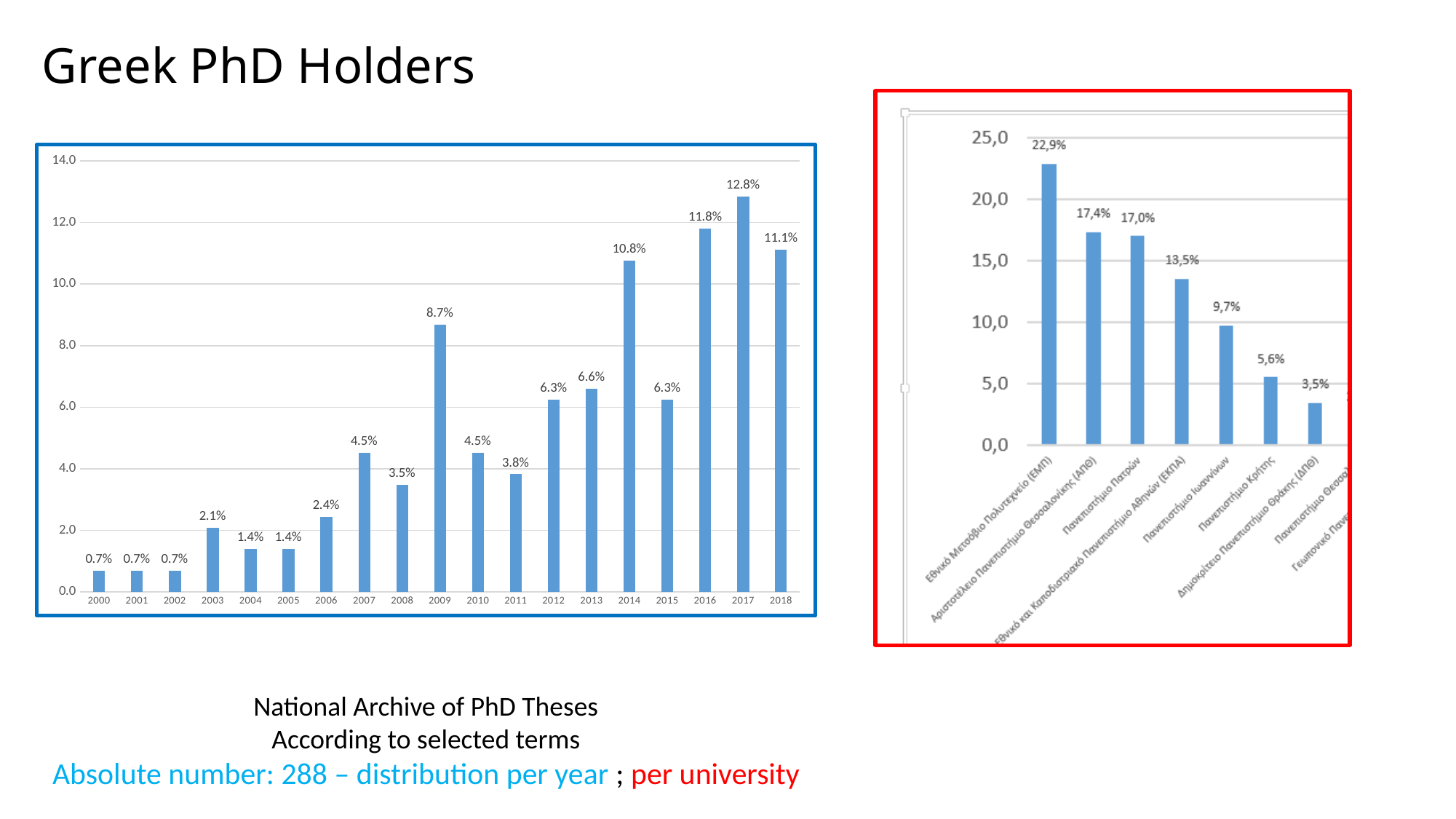
In the left chart (distribution per year), do the values generally rise or fall from 2000 to 2017? Rise In the left chart (distribution per year), what is the value for 2009? 8.7% In the right chart (per university), which university has the highest value? Εθνικό Μετσόβιο Πολυτεχνείο (ΕΜΠ) In the left chart (distribution per year), which year has the highest value? 2017 In the left chart (distribution per year), how many years are shown on the x axis? 19 In the left chart (distribution per year), what is the value for 2017? 12.8% In the right chart (per university), is the value for Πανεπιστήμιο Κρήτης greater or less than 10,0? less In the right chart (per university), what is the value for Πανεπιστήμιο Ιωαννίνων? 9,7% In the left chart (distribution per year), what is the difference between the values for 2016 and 2014? 1.0% In the right chart (per university), what is the difference between the values for ΕΜΠ and ΑΠΘ? 5,5% What kind of chart is the left chart (distribution per year)? Bar chart In the left chart (distribution per year), which is larger, the value for 2013 or the value for 2015? 2013